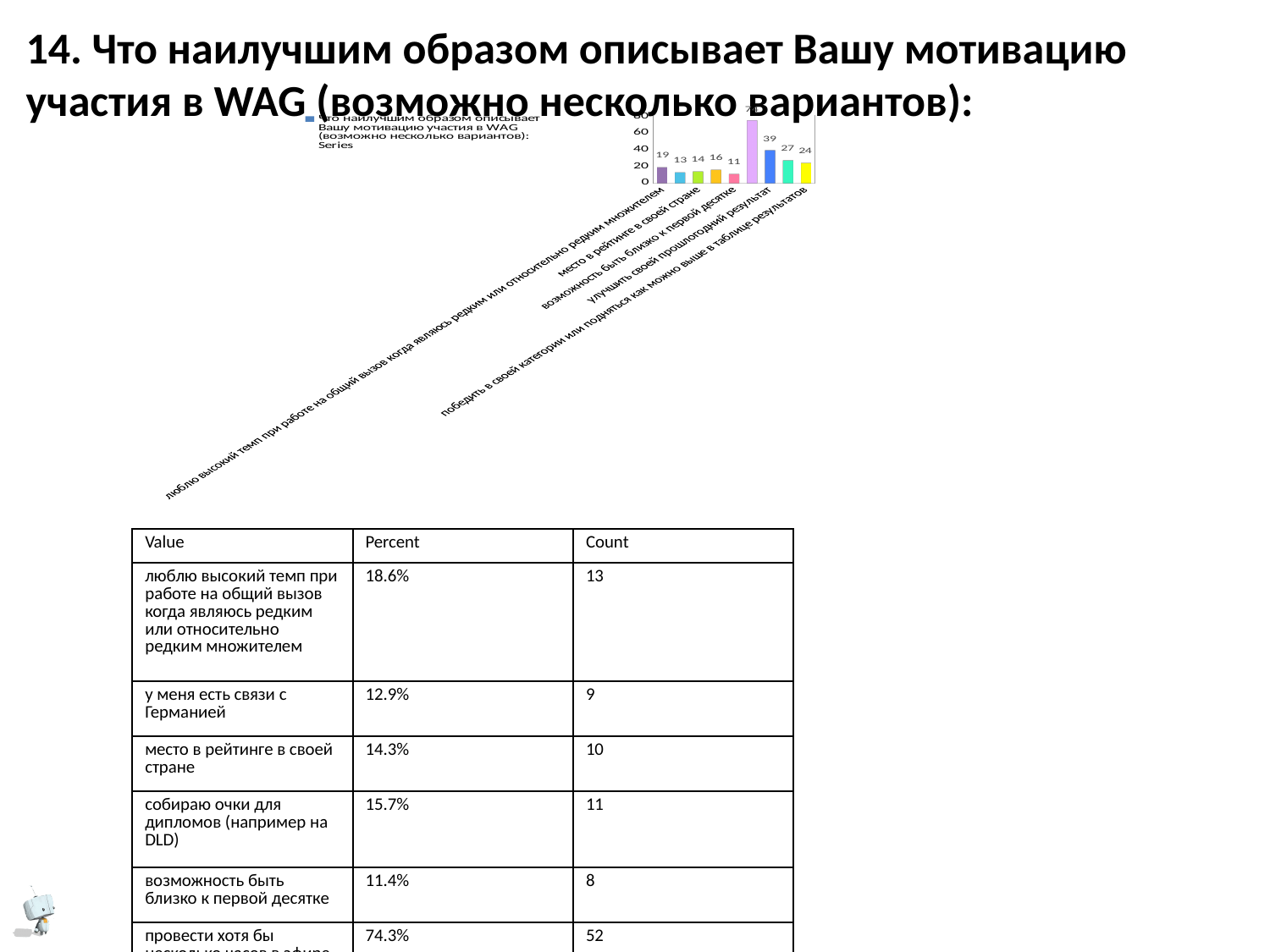
What value is shown for the bar labelled 'люблю высокий темп при работе на общий вызов когда являюсь редким или относительно редким множителем'? 19 What value is shown for the bar labelled 'улучшить свой прошлогодний результат'? 39 How many series does the chart legend list? 1 Is the value for 'улучшить свой прошлогодний результат' greater or less than 20? greater Which has the larger value: 'место в рейтинге в своей стране' or 'возможность быть близко к первой десятке'? место в рейтинге в своей стране Which labelled category has the lowest value in the chart? возможность быть близко к первой десятке What value is shown for the bar labelled 'победить в своей категории или подняться как можно выше в таблице результатов'? 24 How many bars are plotted in the chart? 9 What value is shown for the bar labelled 'возможность быть близко к первой десятке'? 11 What kind of chart is shown on the slide? bar chart What is the difference between the values for 'улучшить свой прошлогодний результат' and 'победить в своей категории или подняться как можно выше в таблице результатов'? 15 What value is shown for the bar labelled 'место в рейтинге в своей стране'? 14